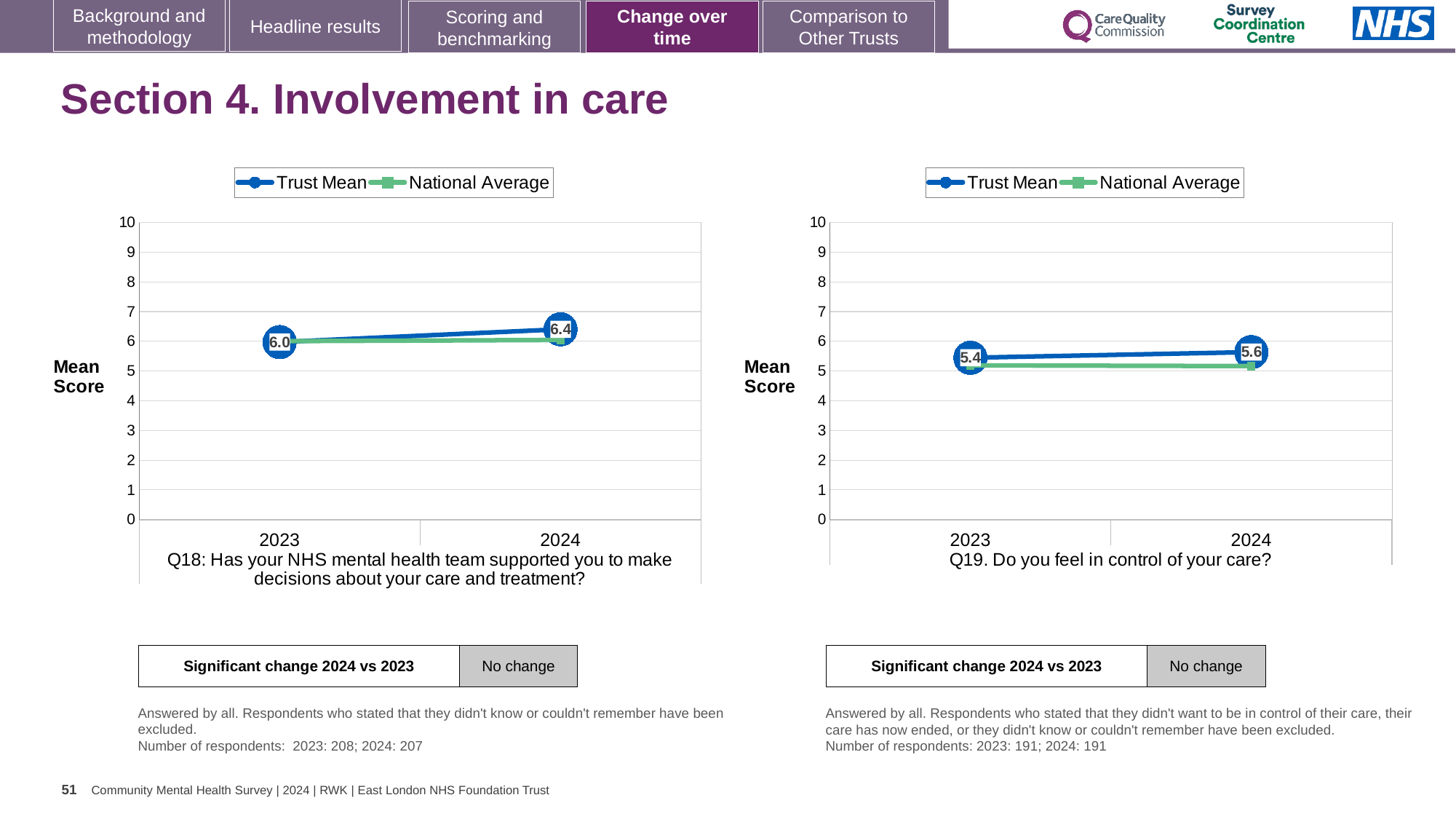
In the Q19 chart, what is the difference between the Trust Mean in 2024 and in 2023? 0.2 What type of chart is used for Q19? line chart In the Q18 chart, by how much did the Trust Mean change from 2023 to 2024? 0.4 In the Q19 chart, is the National Average value for 2024 greater or less than 6? less In the Q18 chart, does the Trust Mean rise or fall from 2023 to 2024? rise In the Q19 chart, what is the Trust Mean score for 2024? 5.6 How many years are plotted on the x axis of the Q19 chart? 2 In the Q19 chart, which year has the higher Trust Mean, 2023 or 2024? 2024 How many series does the legend of the Q18 chart list? 2 In the Q18 chart, what is the Trust Mean score for 2024? 6.4 In the Q18 chart, what is the Trust Mean score for 2023? 6.0 In the Q19 chart, what is the Trust Mean score for 2023? 5.4